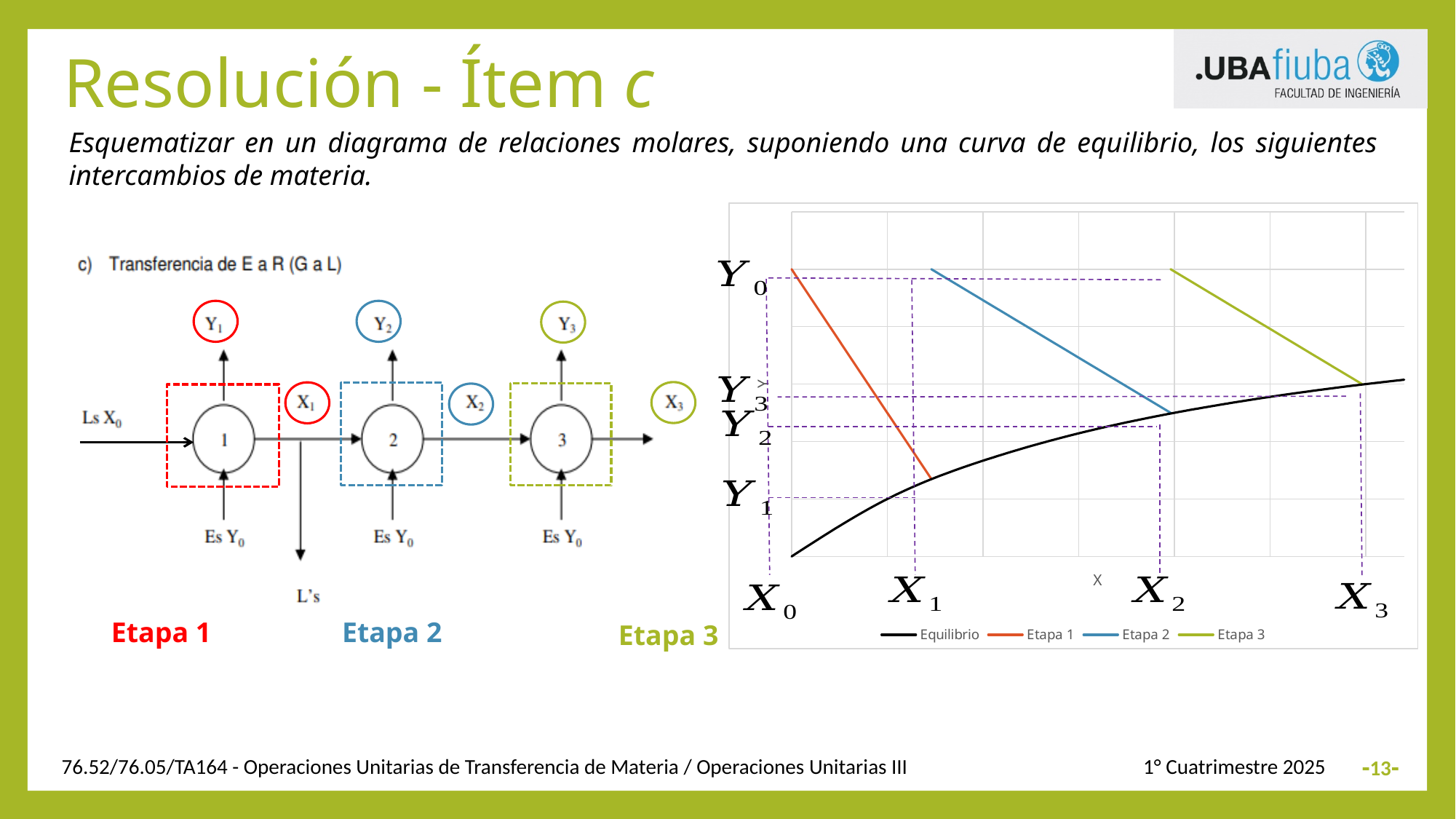
How many series does the legend of the chart list? 4 How many stage (Etapa) lines are plotted in the chart? 3 Which series in the chart is drawn in black? Equilibrio Which of the labelled Y values on the chart is the lowest? Y1 Does the Equilibrio curve rise or fall as X increases? rise Which is larger on the chart's x axis, X3 or X1? X3 Which is larger on the chart's y axis, Y0 or Y1? Y0 Which of the labelled X values on the chart is the highest? X3 What kind of chart is shown on the right of the slide? line chart Which series in the chart is drawn in red? Etapa 1